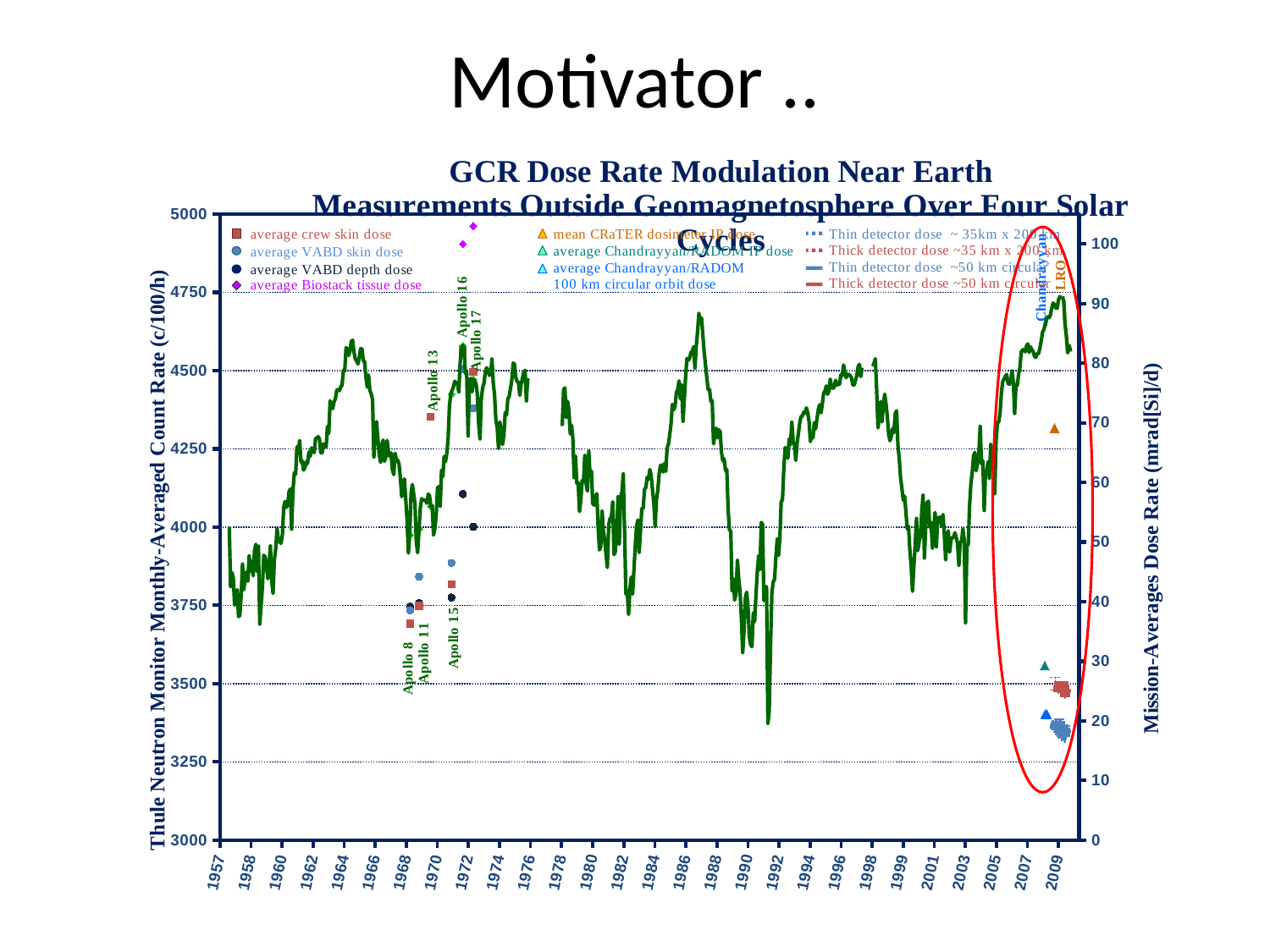
Is the Thule neutron monitor count rate at its low point around 2003 greater or less than 4000? less Is the Thule neutron monitor count rate at its lowest point around 1991 greater or less than 3500? less Does the Thule neutron monitor count rate rise or fall between 1987 and 1991? fall What is the label of the left vertical axis? Thule Neutron Monitor Monthly-Averaged Count Rate (c/100/h) What is the title of the chart? GCR Dose Rate Modulation Near Earth Measurements Outside Geomagnetosphere Over Four Solar Cycles Does the Thule neutron monitor count rate rise or fall between 1991 and 1997? rise Is the Thule neutron monitor count rate at its peak around 2009 greater or less than 4500? greater How many entries does the chart's legend list? 11 What is the maximum value shown on the right vertical axis (Mission-Averages Dose Rate)? 100 What kind of chart is the green data series plotted as? line chart